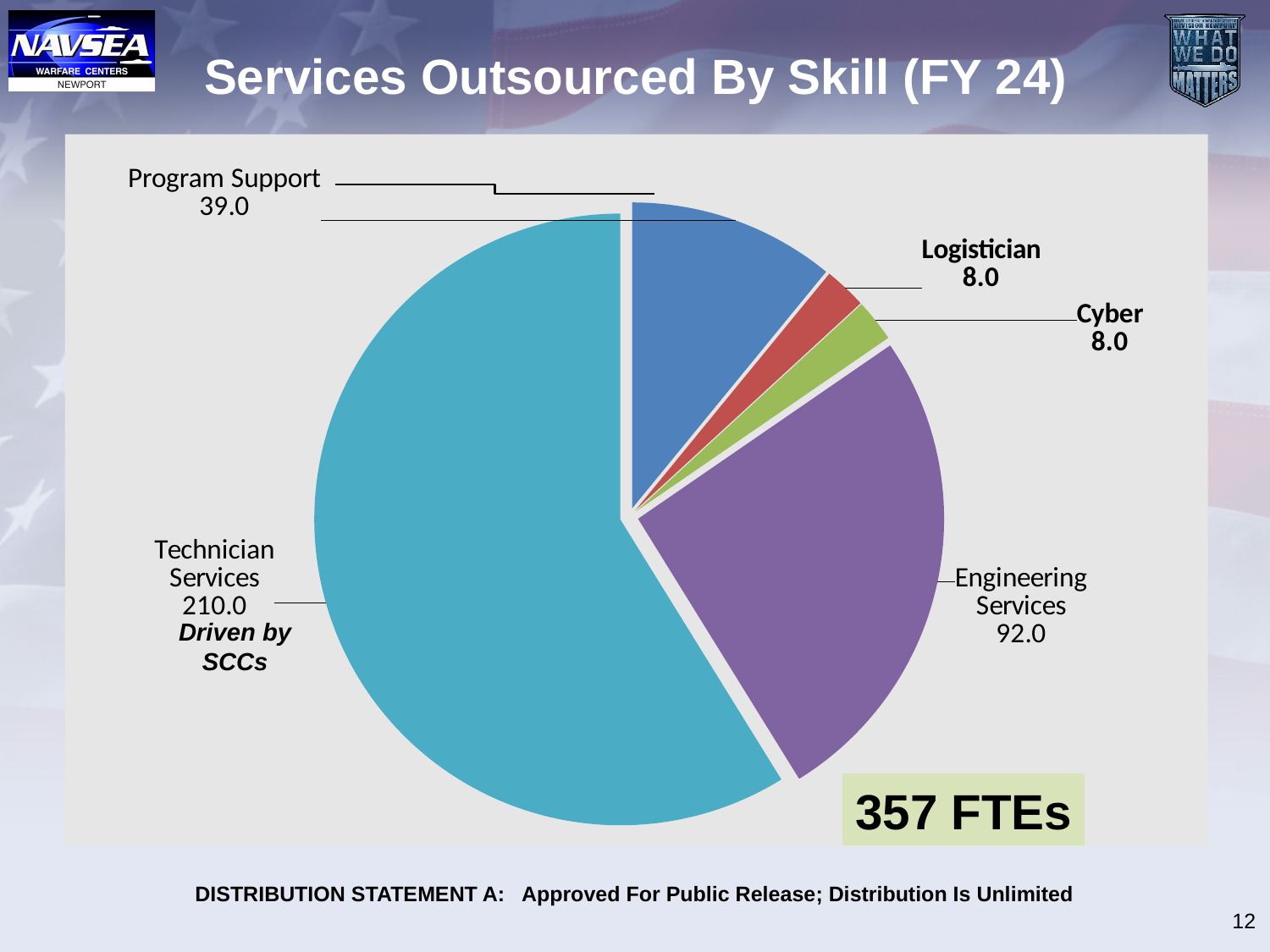
Which category has the largest slice of the pie? Technician Services What is the difference between the values for Technician Services and Engineering Services? 118.0 How many categories are shown in the pie chart? 5 What kind of chart is shown on the slide? Pie chart What is the value for Program Support? 39.0 What is the difference between the values for Engineering Services and Program Support? 53.0 What is the title of the chart? Services Outsourced By Skill (FY 24) What is the value for Cyber? 8.0 Which is larger, the value for Program Support or the value for Logistician? Program Support What is the value for Engineering Services? 92.0 What is the total number of FTEs shown on the slide? 357 FTEs What is the value for Technician Services? 210.0